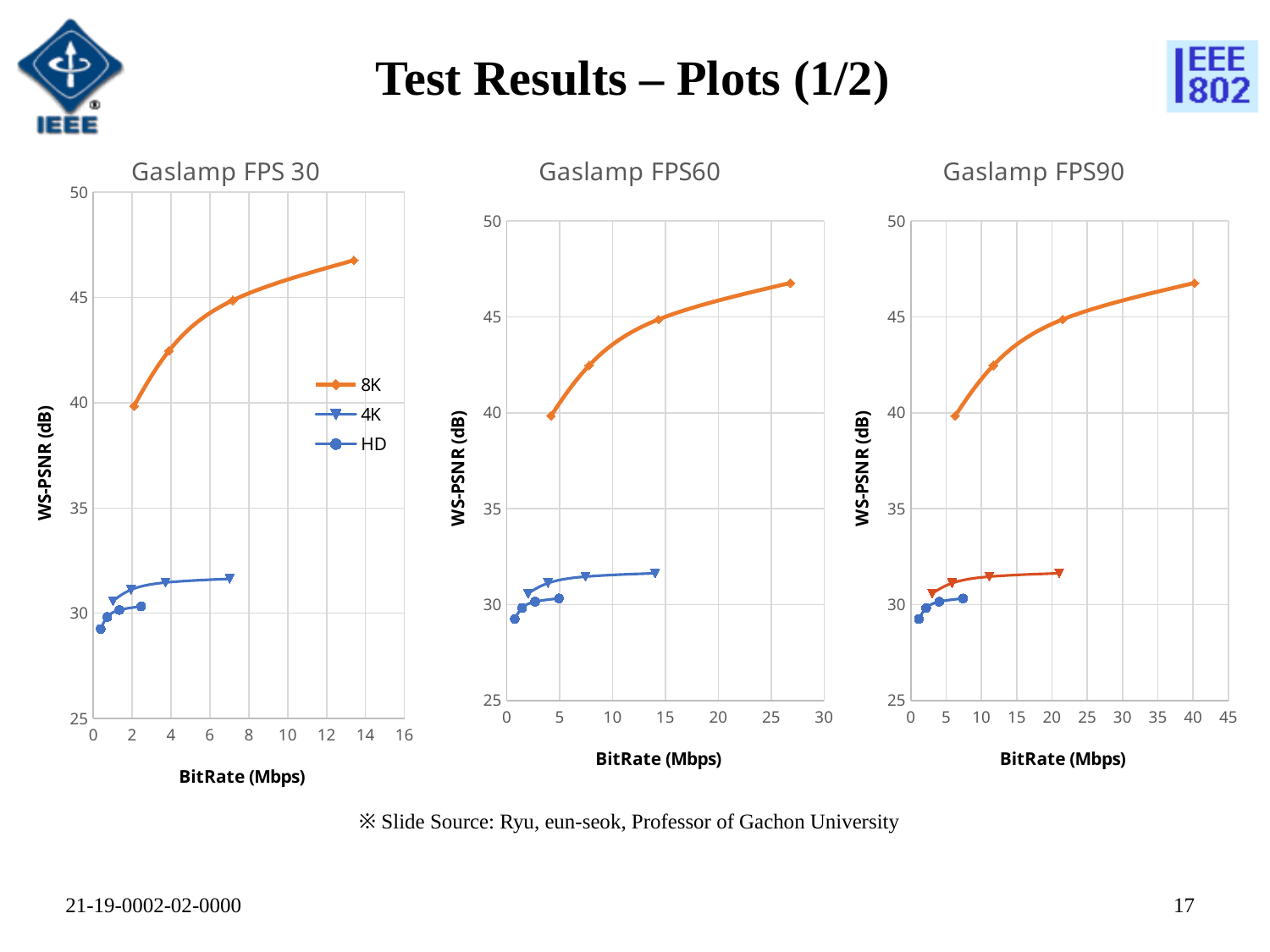
How many series does the legend on the "Gaslamp FPS 30" chart list? 3 What is the y-axis title of the "Gaslamp FPS60" chart? WS-PSNR (dB) In the "Gaslamp FPS 30" chart, which series reaches the highest WS-PSNR value? 8K What is the x-axis title of the "Gaslamp FPS90" chart? BitRate (Mbps) In the "Gaslamp FPS90" chart, does the WS-PSNR of the 8K series rise or fall as BitRate increases? rise What kind of chart is the "Gaslamp FPS 30" chart? line chart In the "Gaslamp FPS60" chart, which series has the higher WS-PSNR at its highest bitrate point, 8K or 4K? 8K In the "Gaslamp FPS 30" chart, which series has the lowest WS-PSNR values? HD In the "Gaslamp FPS 30" chart, how many data points are plotted for the 8K series? 4 In the "Gaslamp FPS 30" chart, is the highest WS-PSNR value of the 8K series greater or less than 45? greater In the "Gaslamp FPS60" chart, is the highest WS-PSNR value of the 4K series greater or less than 35? less